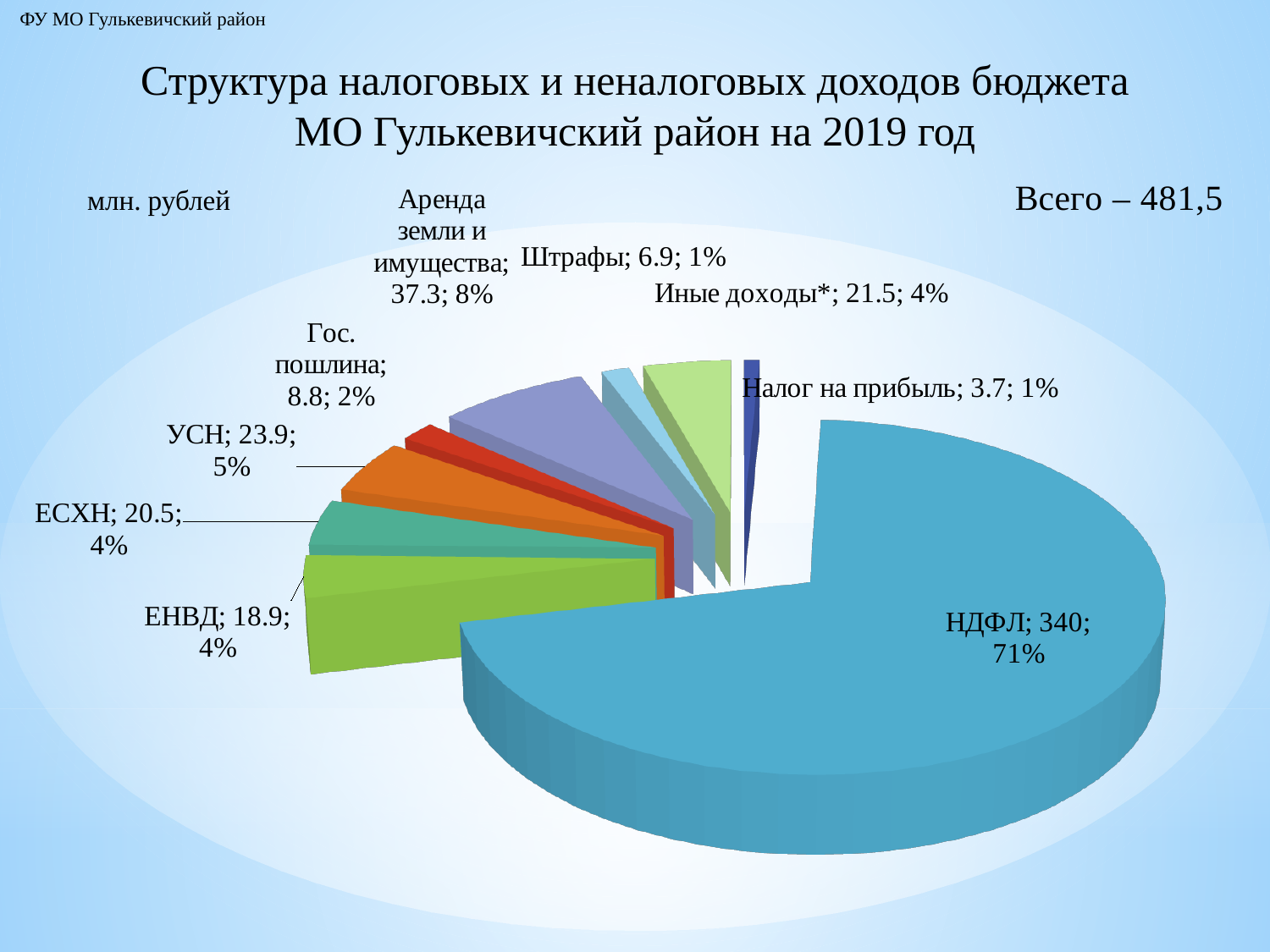
Which category has the largest value? НДФЛ What share of the pie does НДФЛ represent? 71% Which is larger, the value for ЕНВД or the value for Иные доходы*? Иные доходы* What type of chart is shown on the slide? pie chart How many slices does the pie chart have? 9 Which category has the smallest value? Налог на прибыль What is the value for УСН? 23.9 What share of the pie does Штрафы represent? 1% What total is stated on the slide for the chart? 481,5 What is the difference between the values for УСН and ЕСХН? 3.4 What is the value for НДФЛ? 340 What is the value for Аренда земли и имущества? 37.3